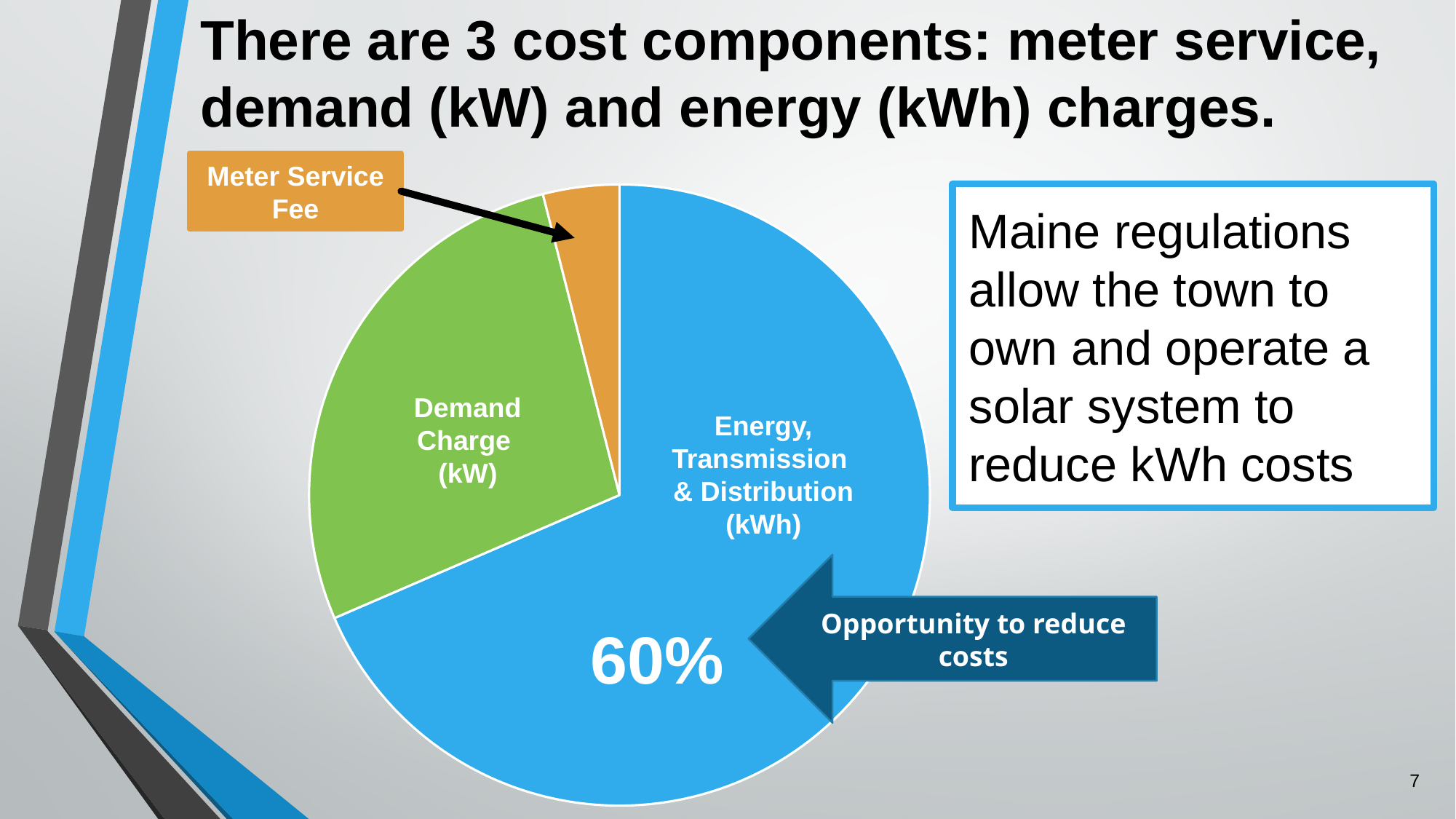
Which slice of the pie chart is the smallest? Meter Service Fee How many slices does the pie chart have? 3 What colour is the Demand Charge (kW) slice? green What share of the pie does the Energy, Transmission & Distribution (kWh) slice represent? 60% Which is larger, the Demand Charge (kW) slice or the Meter Service Fee slice? Demand Charge (kW) Which is larger, the Energy, Transmission & Distribution (kWh) slice or the Demand Charge (kW) slice? Energy, Transmission & Distribution (kWh) What kind of chart is shown on the slide? pie chart Which slice of the pie chart is the largest? Energy, Transmission & Distribution (kWh) Is the share of the Energy, Transmission & Distribution (kWh) slice greater or less than 50%? greater What colour is the Meter Service Fee slice? orange